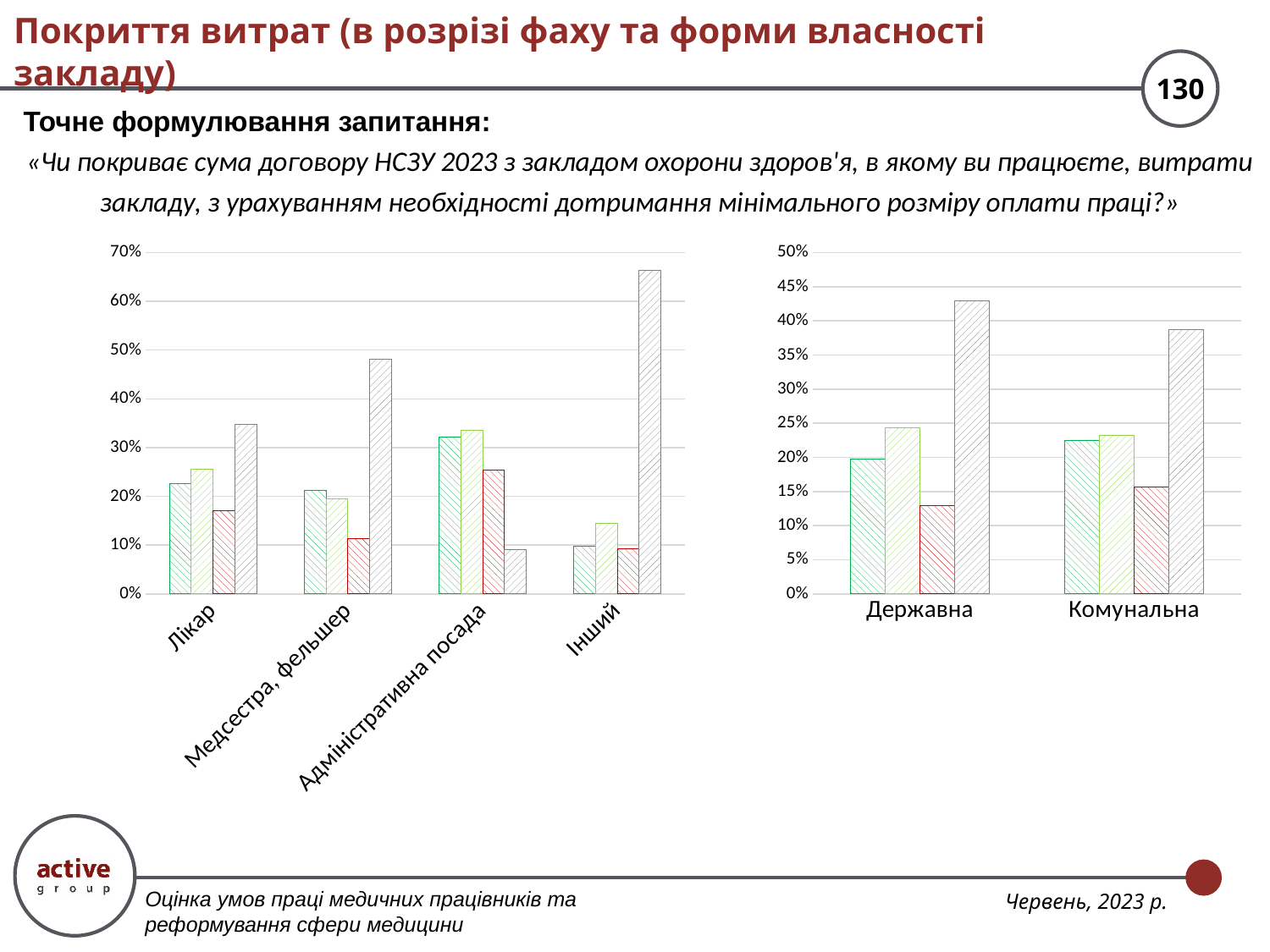
In the left chart, is the value of the red hatched bar for Медсестра, фельшер greater or less than 15%? less How many categories are shown on the x axis of the right chart? 2 What is the highest value shown on the y axis of the left chart? 70% In the left chart, how many bars are plotted for each category? 4 In the right chart, is the value of the grey hatched bar for Державна greater or less than 40%? greater In the left chart, is the value of the grey hatched bar for Адміністративна посада greater or less than 10%? less How many categories are shown on the x axis of the left chart? 4 What kind of chart is the left chart on the slide? bar chart In the right chart, is the grey hatched bar larger for Державна or for Комунальна? Державна In the left chart, which category contains the tallest bar? Інший